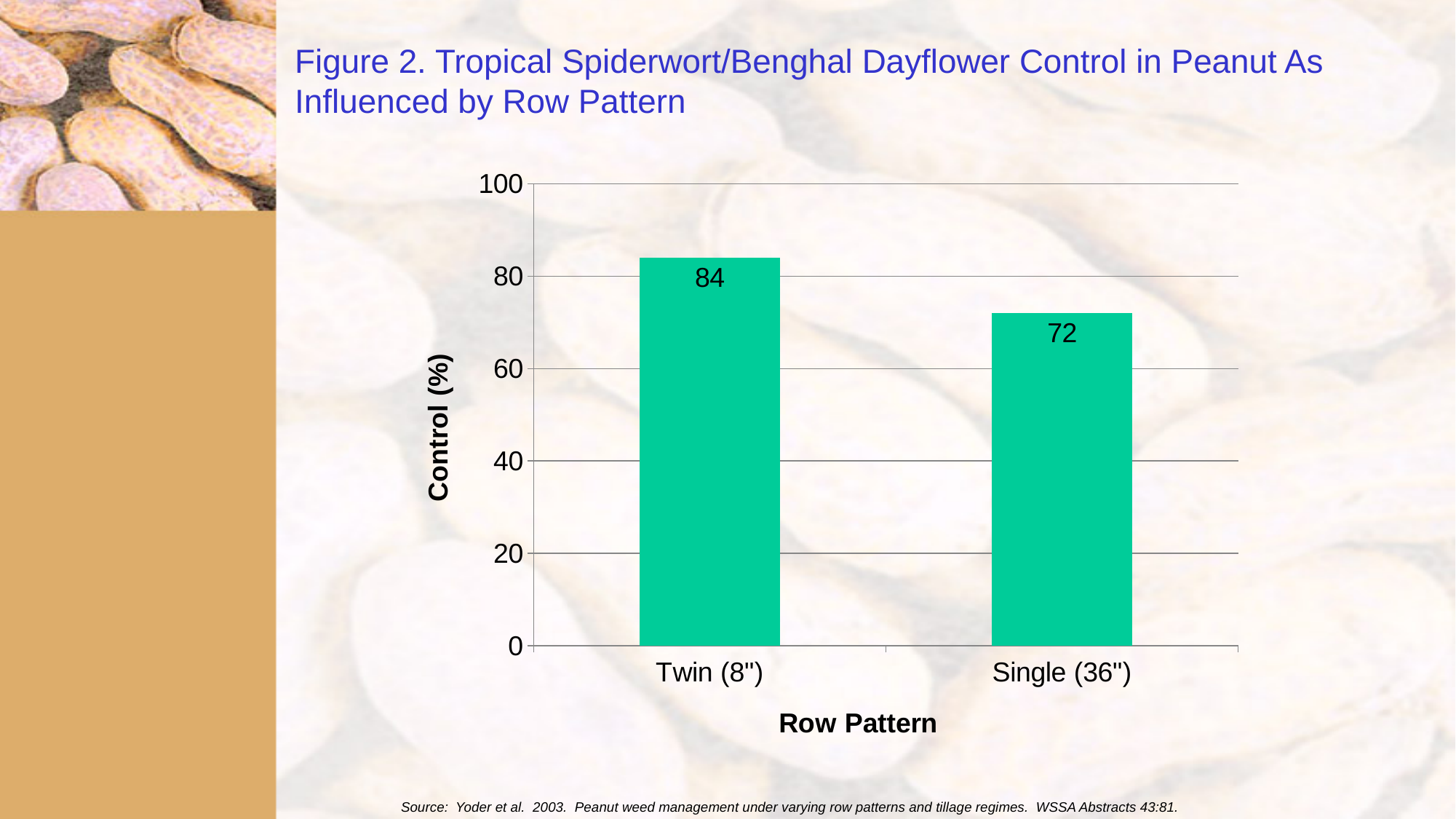
What kind of chart is shown on the slide? bar chart What is the control (%) value for the Twin (8") row pattern? 84 Which row pattern has the lowest control (%)? Single (36") What is the difference in control (%) between the Twin (8") and Single (36") row patterns? 12 Is the control (%) value for Twin (8") greater or less than 80? greater Is the control (%) value for Single (36") greater or less than 80? less Which has a larger control (%) value, Twin (8") or Single (36")? Twin (8") What is the label of the x-axis? Row Pattern What is the label of the y-axis? Control (%) Which row pattern has the highest control (%)? Twin (8") How many row pattern categories are shown in the chart? 2 What is the control (%) value for the Single (36") row pattern? 72